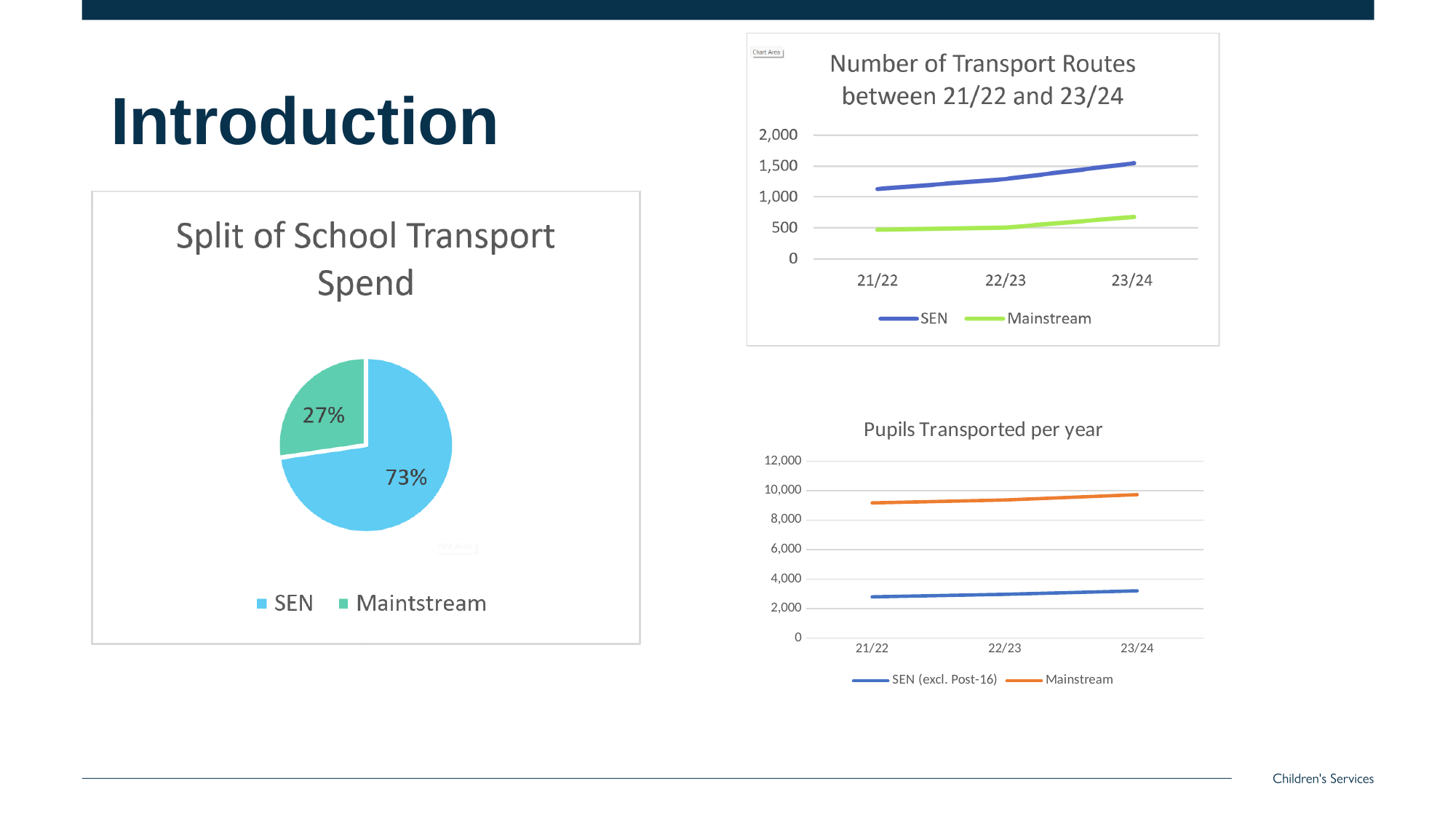
In the 'Number of Transport Routes between 21/22 and 23/24' chart, does the SEN series rise or fall from 21/22 to 23/24? Rise In the 'Pupils Transported per year' chart, which series is higher in 23/24, SEN (excl. Post-16) or Mainstream? Mainstream In the 'Number of Transport Routes between 21/22 and 23/24' chart, how many series does the legend list? 2 In the 'Split of School Transport Spend' chart, what is the difference in percentage points between the SEN and Maintstream shares? 46 What kind of chart is 'Split of School Transport Spend'? Pie chart In the 'Pupils Transported per year' chart, how many years are shown on the x axis? 3 In the 'Split of School Transport Spend' chart, which category has the larger share? SEN In the 'Split of School Transport Spend' chart, what share of spend is SEN? 73% What kind of chart is 'Number of Transport Routes between 21/22 and 23/24'? Line chart In the 'Split of School Transport Spend' chart, what share of spend is Maintstream? 27%